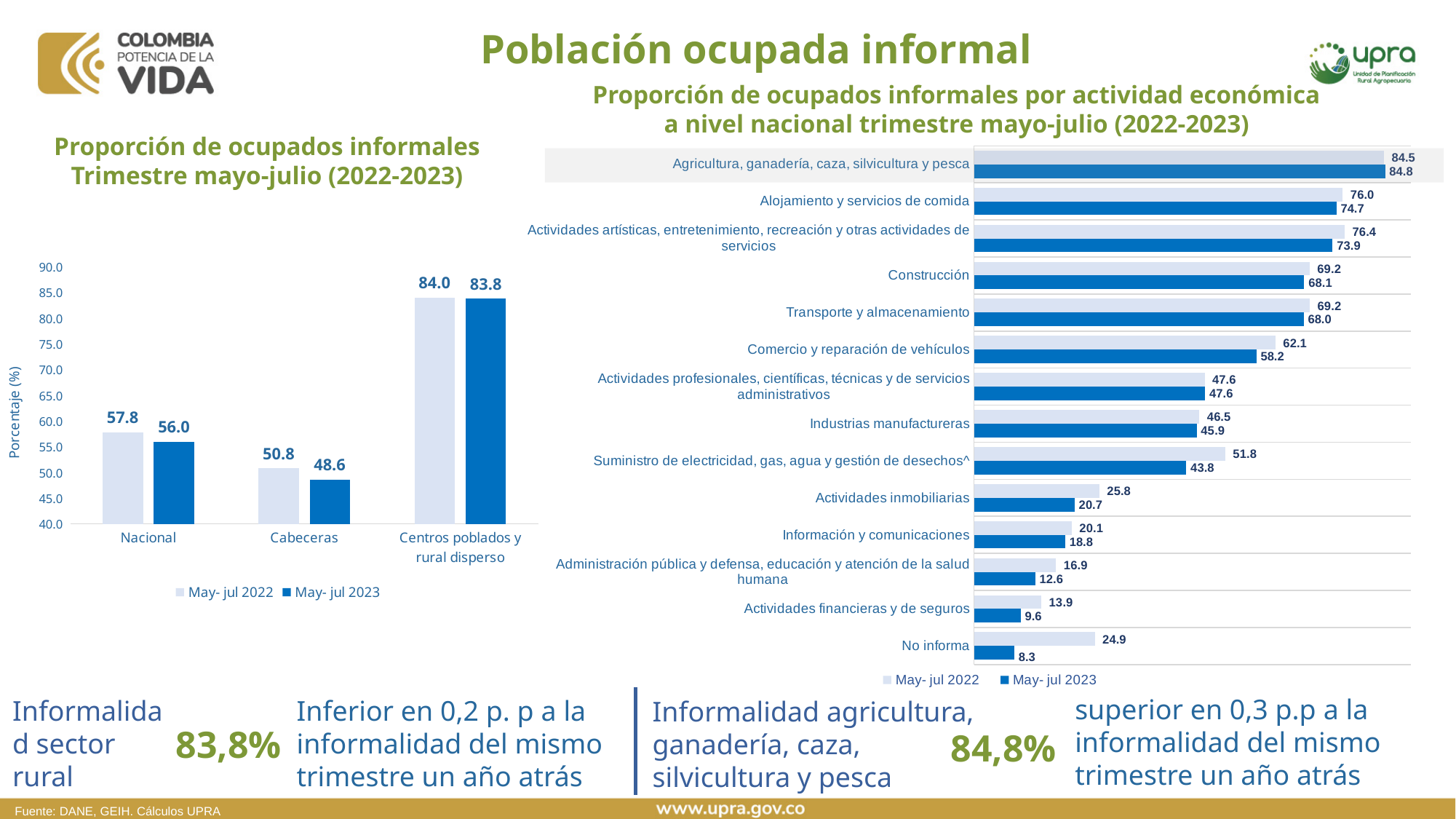
In the right chart 'Proporción de ocupados informales por actividad económica', which is larger for Comercio y reparación de vehículos: the May-jul 2022 value or the May-jul 2023 value? May-jul 2022 In the right chart 'Proporción de ocupados informales por actividad económica', what is the May-jul 2022 value for Actividades inmobiliarias? 25.8 In the left chart 'Proporción de ocupados informales Trimestre mayo-julio (2022-2023)', what is the difference between the May-jul 2022 and May-jul 2023 values for Nacional? 1.8 In the right chart 'Proporción de ocupados informales por actividad económica', what is the May-jul 2023 value for Construcción? 68.1 In the right chart 'Proporción de ocupados informales por actividad económica', what is the difference between the May-jul 2022 and May-jul 2023 values for Suministro de electricidad, gas, agua y gestión de desechos^? 8.0 In the left chart 'Proporción de ocupados informales Trimestre mayo-julio (2022-2023)', what is the value for Nacional in May-jul 2023? 56.0 In the right chart 'Proporción de ocupados informales por actividad económica', how many economic activities are listed? 14 In the right chart 'Proporción de ocupados informales por actividad económica', which activity has the lowest May-jul 2023 value? No informa In the left chart 'Proporción de ocupados informales Trimestre mayo-julio (2022-2023)', how many series does the legend list? 2 In the left chart 'Proporción de ocupados informales Trimestre mayo-julio (2022-2023)', which category has the highest value in May-jul 2023? Centros poblados y rural disperso In the left chart 'Proporción de ocupados informales Trimestre mayo-julio (2022-2023)', what is the value for Cabeceras in May-jul 2022? 50.8 What kind of chart is the left chart 'Proporción de ocupados informales Trimestre mayo-julio (2022-2023)'? Bar chart